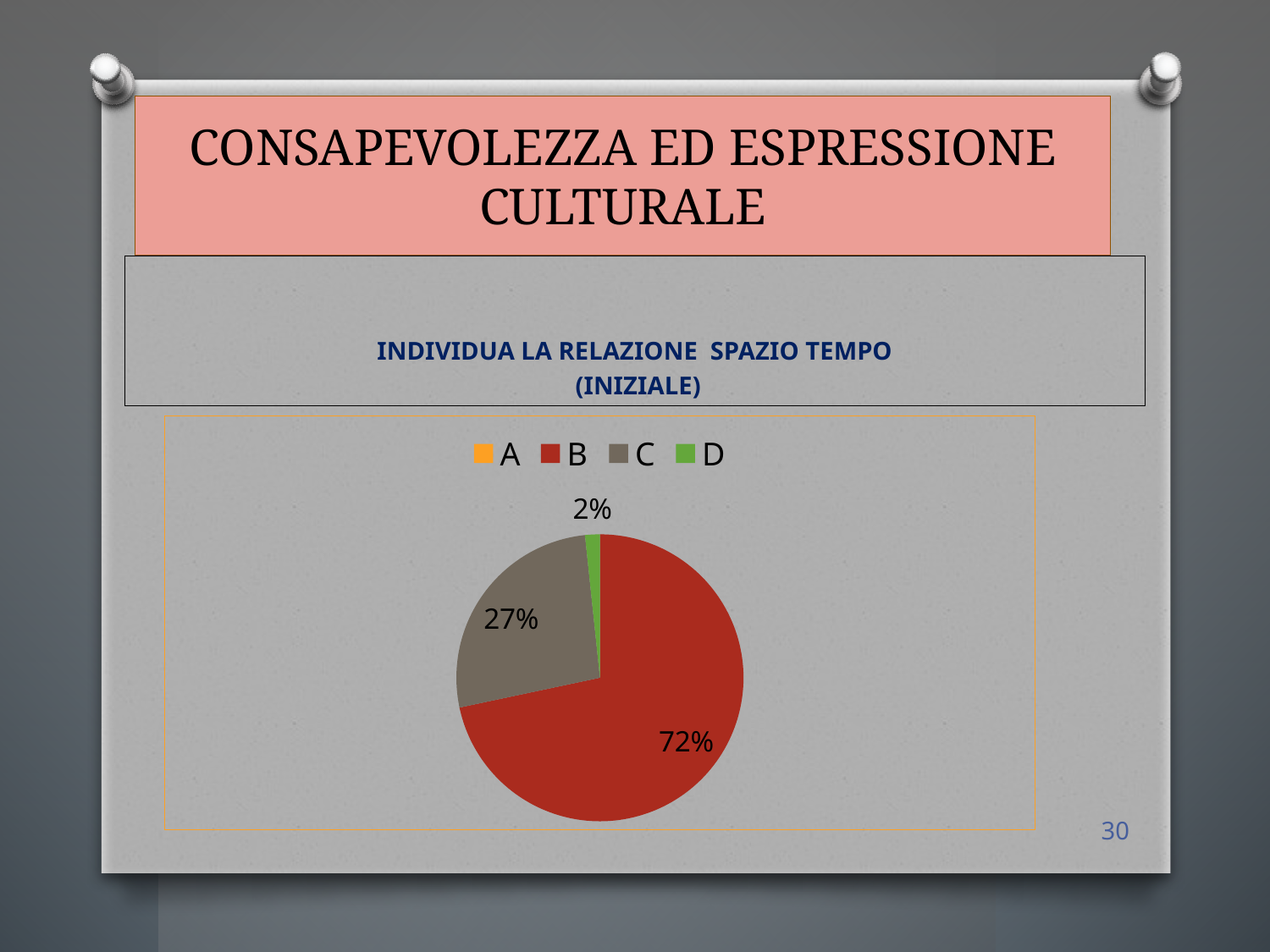
What is the difference in percentage points between the slices for B and C? 45 What percentage of the pie does category C represent? 27% What percentage of the pie does category D represent? 2% Among the slices shown with a percentage label, which category has the smallest slice? D What colour represents category B in the legend? red Which category has the largest slice of the pie? B What kind of chart is shown on the slide? pie chart What percentage of the pie does category B represent? 72% Which slice is larger, C or D? C How many categories does the legend list? 4 What is the title of the chart? INDIVIDUA LA RELAZIONE SPAZIO TEMPO (INIZIALE) Is the share for category B greater or less than 50%? greater